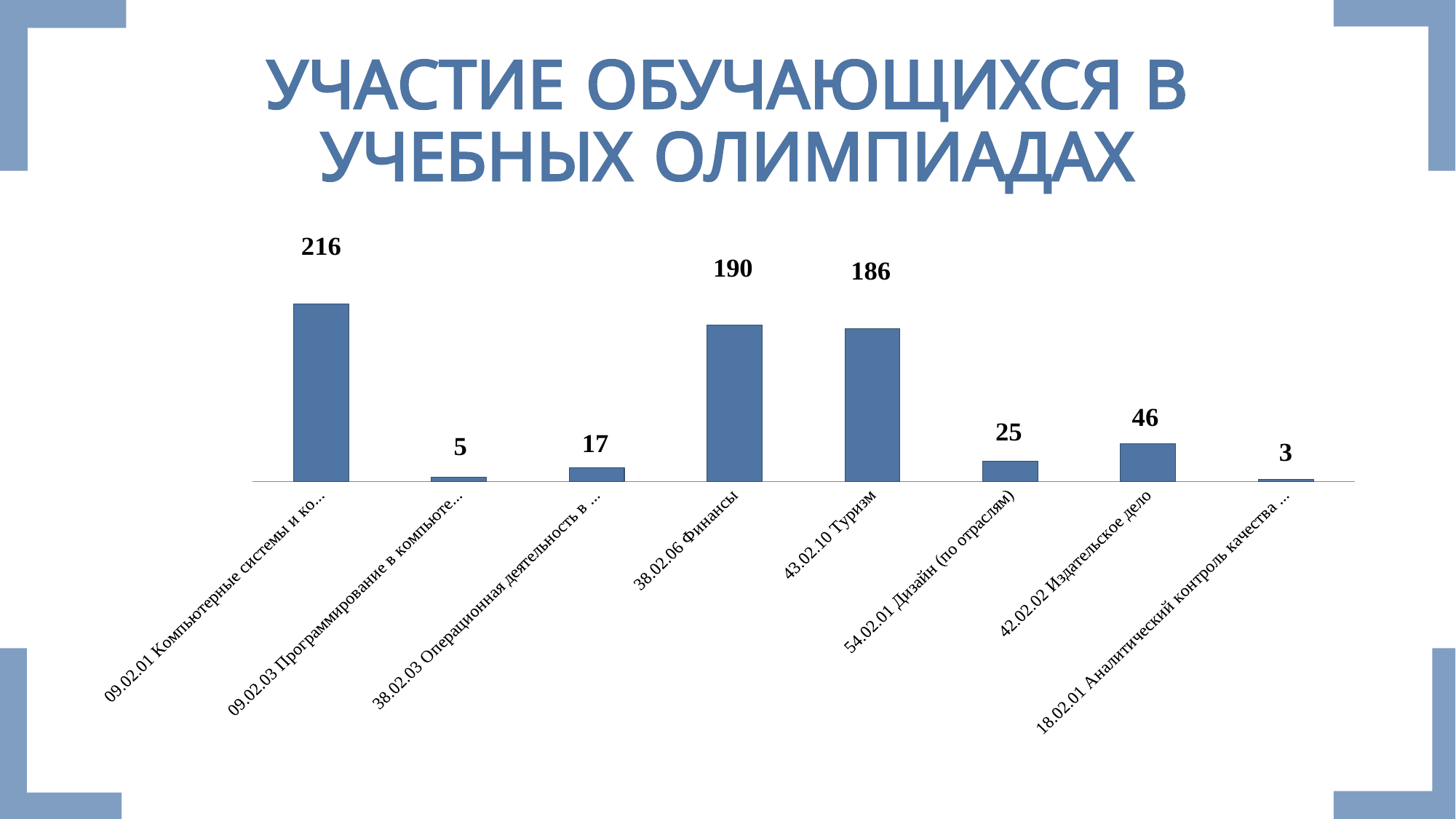
What is the value for 38.02.06 Финансы? 190 What is the value for 54.02.01 Дизайн (по отраслям)? 25 Which category has the lowest value? 18.02.01 Аналитический контроль качества ... Which is larger, the value for 38.02.06 Финансы or the value for 42.02.02 Издательское дело? 38.02.06 Финансы What is the value for the category with code 09.02.01? 216 What is the difference between the values for 38.02.06 Финансы and 43.02.10 Туризм? 4 What is the value for 42.02.02 Издательское дело? 46 What is the value for 43.02.10 Туризм? 186 What kind of chart is shown on the slide? Bar chart Which category has the highest value? 09.02.01 Компьютерные системы и ко... How many categories are shown in the chart? 8 What is the difference between the values for 42.02.02 Издательское дело and 54.02.01 Дизайн (по отраслям)? 21